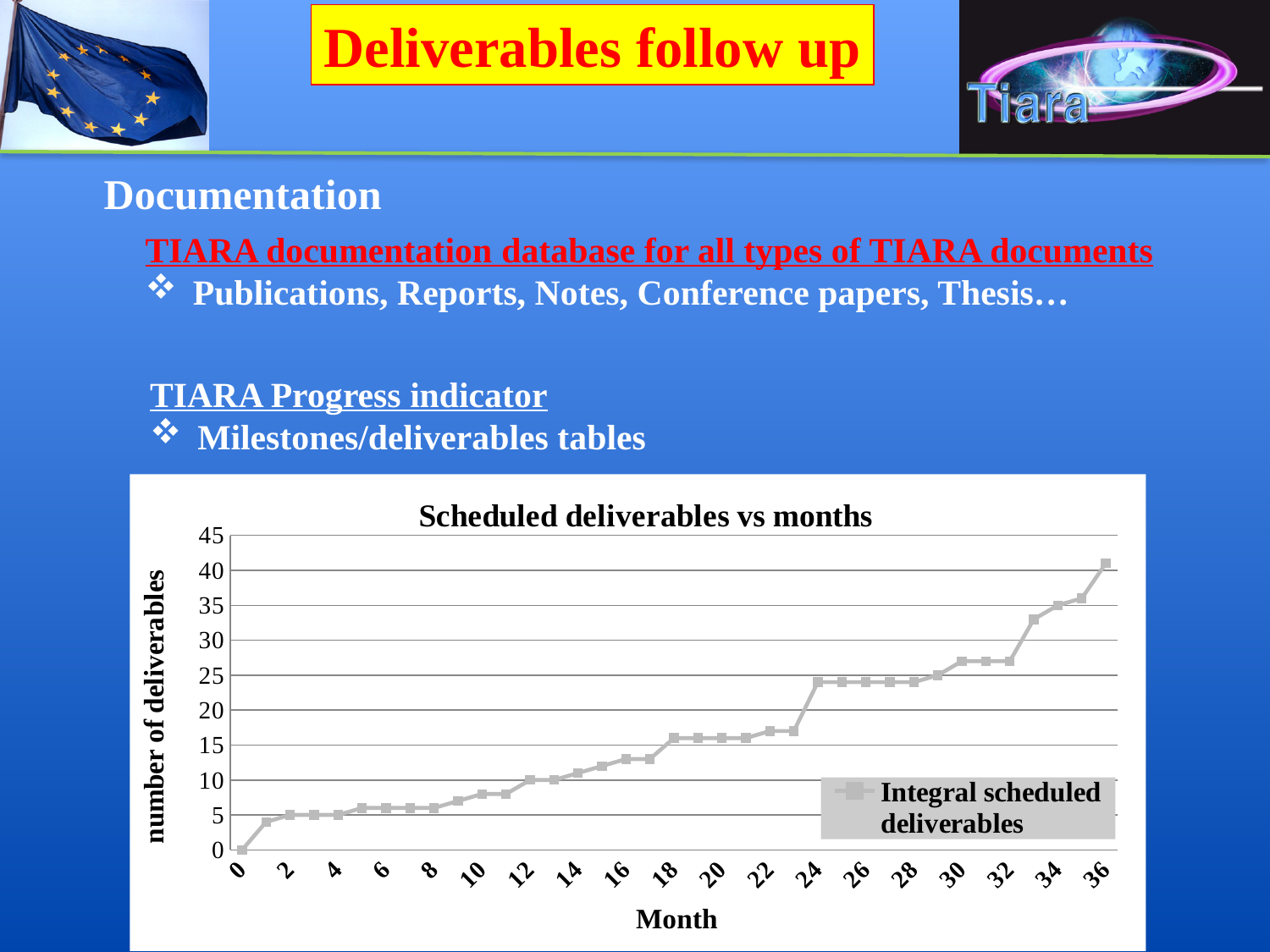
Is the value at month 36 greater or less than 40? greater Which month has the larger value, month 18 or month 30? 30 How many series does the chart legend list? 1 What is the number of deliverables at month 0? 0 Is the value at month 20 greater or less than 20? less What is the title of the chart? Scheduled deliverables vs months What kind of chart is shown on the slide? line chart Do the values rise or fall as the month increases along the x axis? rise At which month is the number of scheduled deliverables lowest? 0 At which month is the number of scheduled deliverables highest? 36 Is the value at month 26 greater or less than 20? greater What is the name of the series shown in the legend? Integral scheduled deliverables